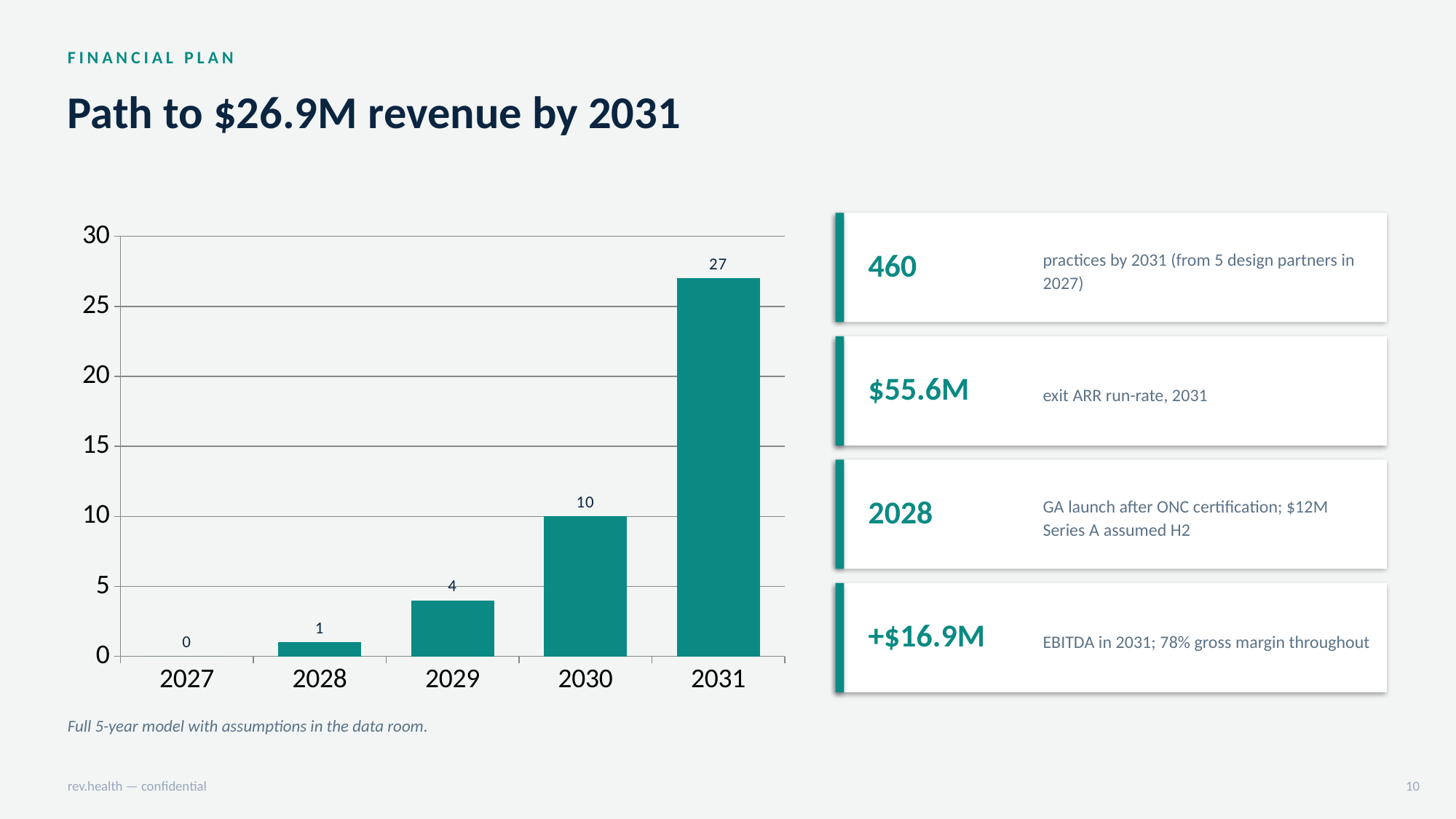
What is the value for 2027? 0 What is the value for 2028? 1 What is the value for 2029? 4 Which year has the lowest value? 2027 Which is larger, the value for 2029 or the value for 2030? 2030 Do the values rise or fall from 2027 to 2031? rise How many years are shown on the x axis? 5 Is the value for 2031 greater or less than 25? greater What is the difference between the values for 2031 and 2030? 17 What is the value for 2031? 27 Which year has the highest value? 2031 What kind of chart is shown on the slide? bar chart